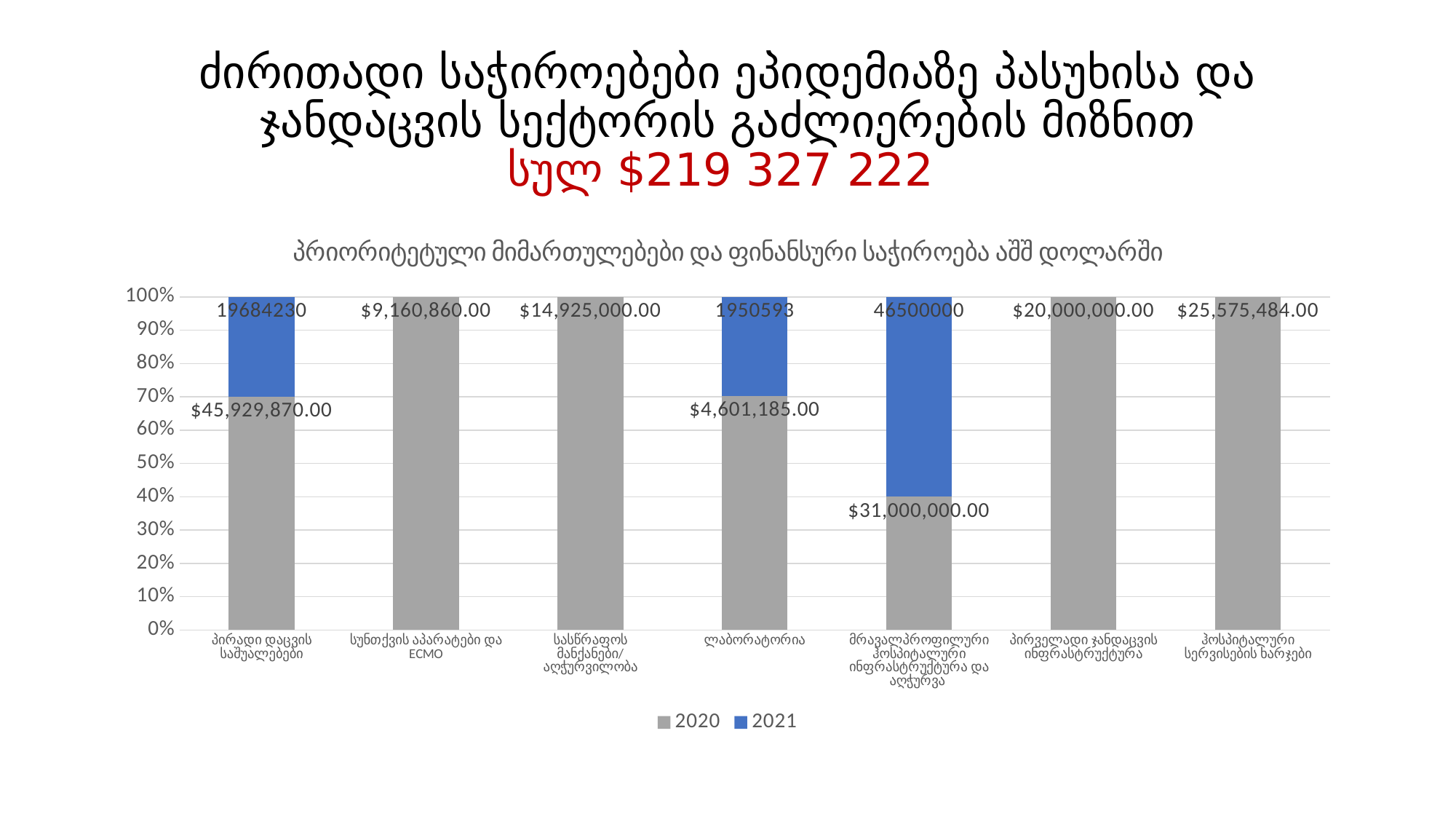
How many series does the chart legend list? 2 Which category has the highest 2020 value? პირადი დაცვის საშუალებები What is the 2020 value for სუნთქვის აპარატები და ECMO? $9,160,860.00 What is the 2021 value for მრავალპროფილური ჰოსპიტალური ინფრასტრუქტურა და აღჭურვა? 46500000 What is the 2021 value for პირადი დაცვის საშუალებები? 19684230 What are the two series named in the chart legend? 2020 and 2021 What kind of chart is shown on the slide? Stacked bar chart How many categories are shown along the x axis of the chart? 7 What is the 2020 value for ლაბორატორია? $4,601,185.00 What is the 2020 value for პირადი დაცვის საშუალებები? $45,929,870.00 Is the 2021 share of the bar for მრავალპროფილური ჰოსპიტალური ინფრასტრუქტურა და აღჭურვა greater or less than 50%? greater Which category has the lowest 2020 value? ლაბორატორია